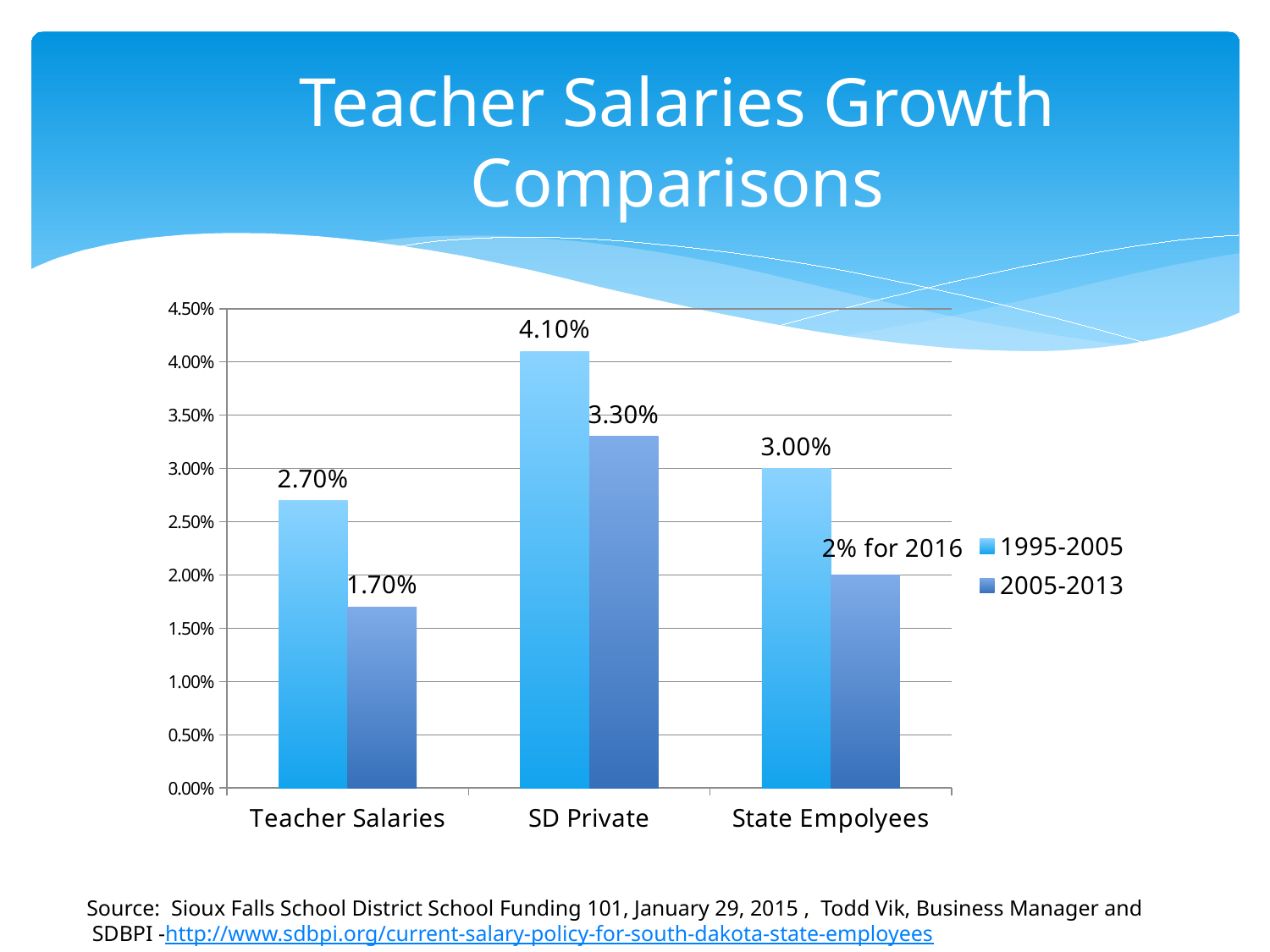
What is the 2005-2013 value for SD Private? 3.30% Which category has the highest 1995-2005 value? SD Private What is the 2005-2013 value for Teacher Salaries? 1.70% What kind of chart is shown on the slide? bar chart What is the 1995-2005 value for Teacher Salaries? 2.70% Which is larger: the 2005-2013 value for SD Private or the 1995-2005 value for State Empolyees? 2005-2013 value for SD Private How many series does the legend list? 2 What is the 1995-2005 value for State Empolyees? 3.00% What is the 1995-2005 value for SD Private? 4.10% How many categories are shown on the x axis? 3 What is the difference between the 1995-2005 and 2005-2013 values for Teacher Salaries? 1.00% Which category has the lowest 2005-2013 value? Teacher Salaries